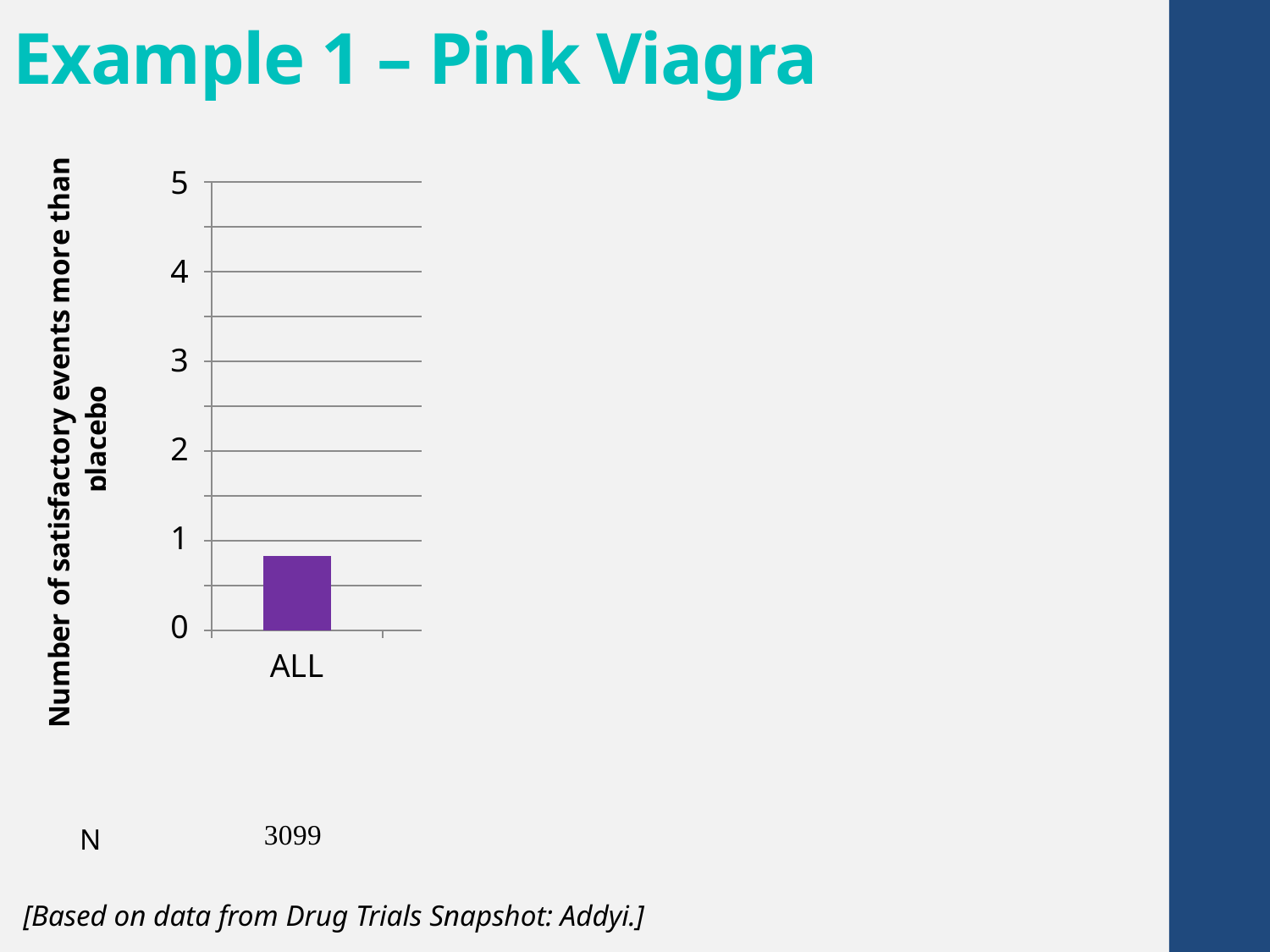
How many categories are plotted on the x axis of the chart? 1 What is the highest value shown on the y axis of the chart? 5 Is the value for ALL greater or less than 1? less What kind of chart is shown on the slide? bar chart What is the y-axis title of the chart? Number of satisfactory events more than placebo What is the label of the only category on the x axis? ALL Is the value for ALL greater or less than 2? less